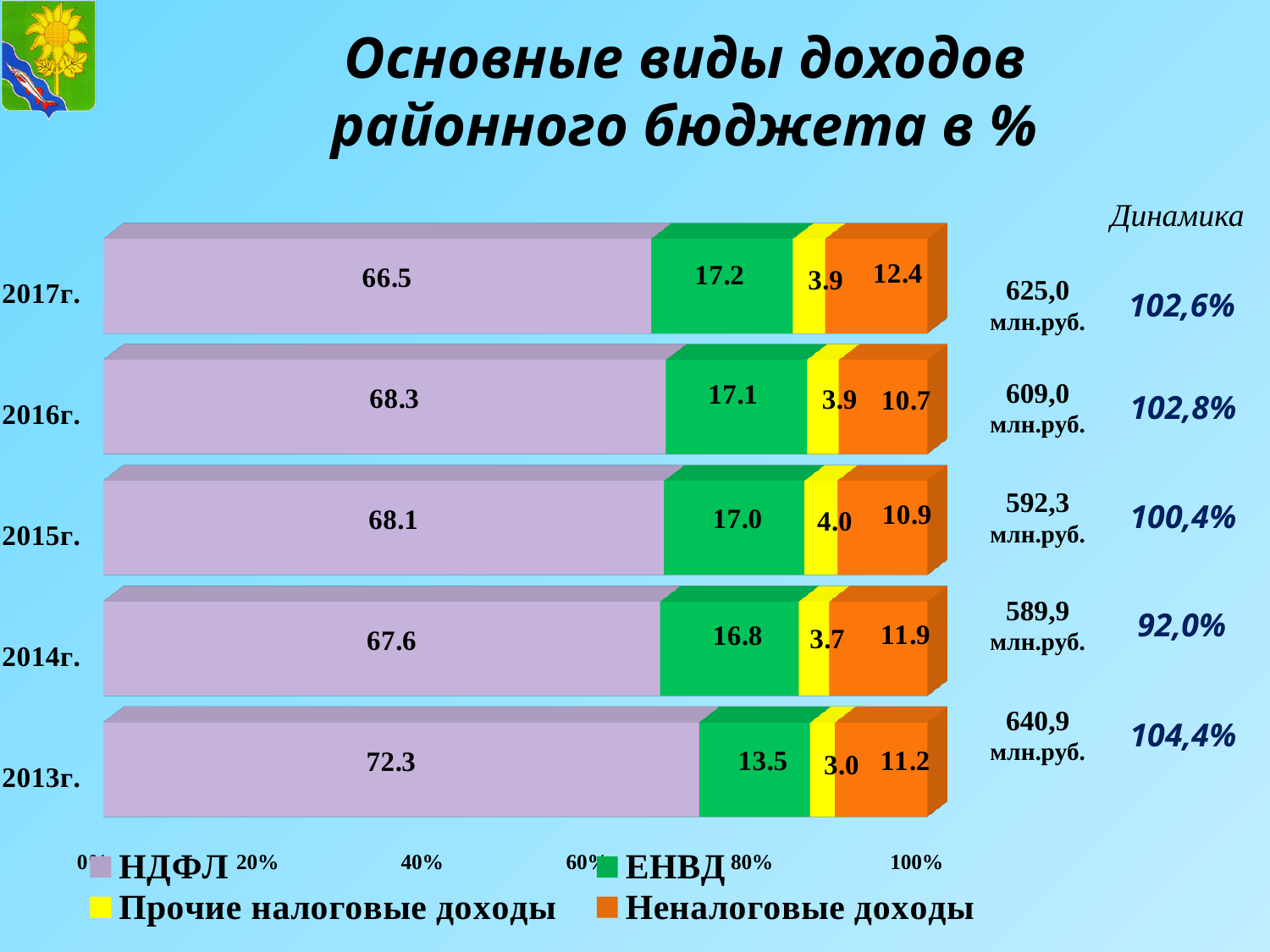
What is the difference between the НДФЛ value in 2013г. and in 2017г.? 5.8 What kind of chart is shown on the slide? Stacked bar chart In which year is the НДФЛ share the highest? 2013г. What is the value for НДФЛ in 2017г.? 66.5 How many series does the legend list? 4 What is the value for ЕНВД in 2013г.? 13.5 What is the value for Прочие налоговые доходы in 2015г.? 4.0 What is the value for Неналоговые доходы in 2014г.? 11.9 Which year has the larger Неналоговые доходы value, 2017г. or 2016г.? 2017г. How many years are shown in the chart? 5 In which year is the ЕНВД share the lowest? 2013г. Does the ЕНВД share rise or fall from 2013г. to 2017г.? Rise